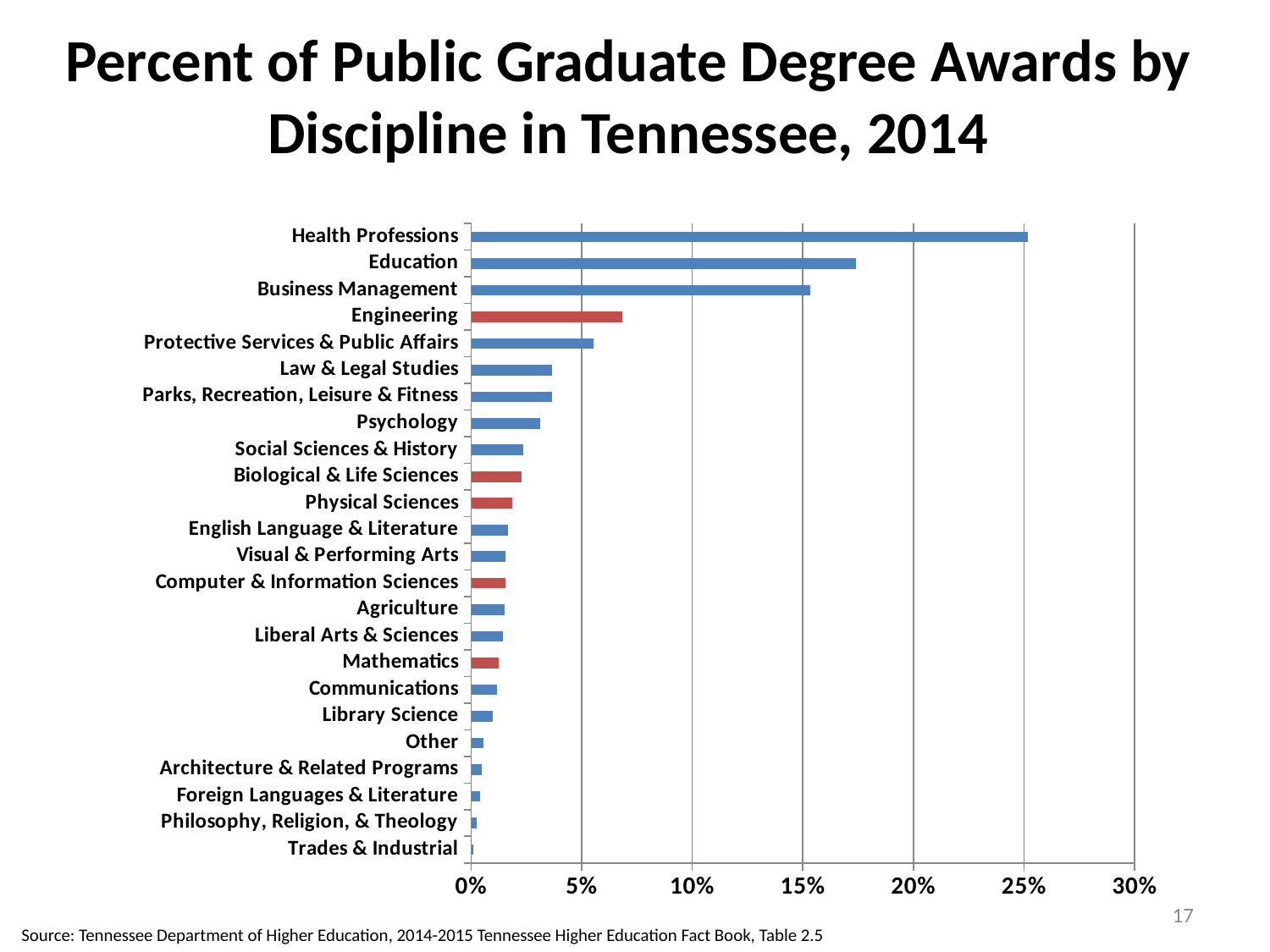
Which discipline has the highest percent of public graduate degree awards? Health Professions Going down the chart from Health Professions to Trades & Industrial, do the bars get longer or shorter? shorter Is the value for Education greater or less than 15%? greater Which has a larger share of graduate degree awards, Engineering or Protective Services & Public Affairs? Engineering Is the value for Health Professions greater or less than 20%? greater Which has a larger share of graduate degree awards, Education or Business Management? Education Is the value for Psychology greater or less than 5%? less What colour is the bar for Engineering? red What kind of chart is shown on the slide? bar chart Which discipline has the lowest percent of public graduate degree awards? Trades & Industrial How many disciplines are listed on the chart? 24